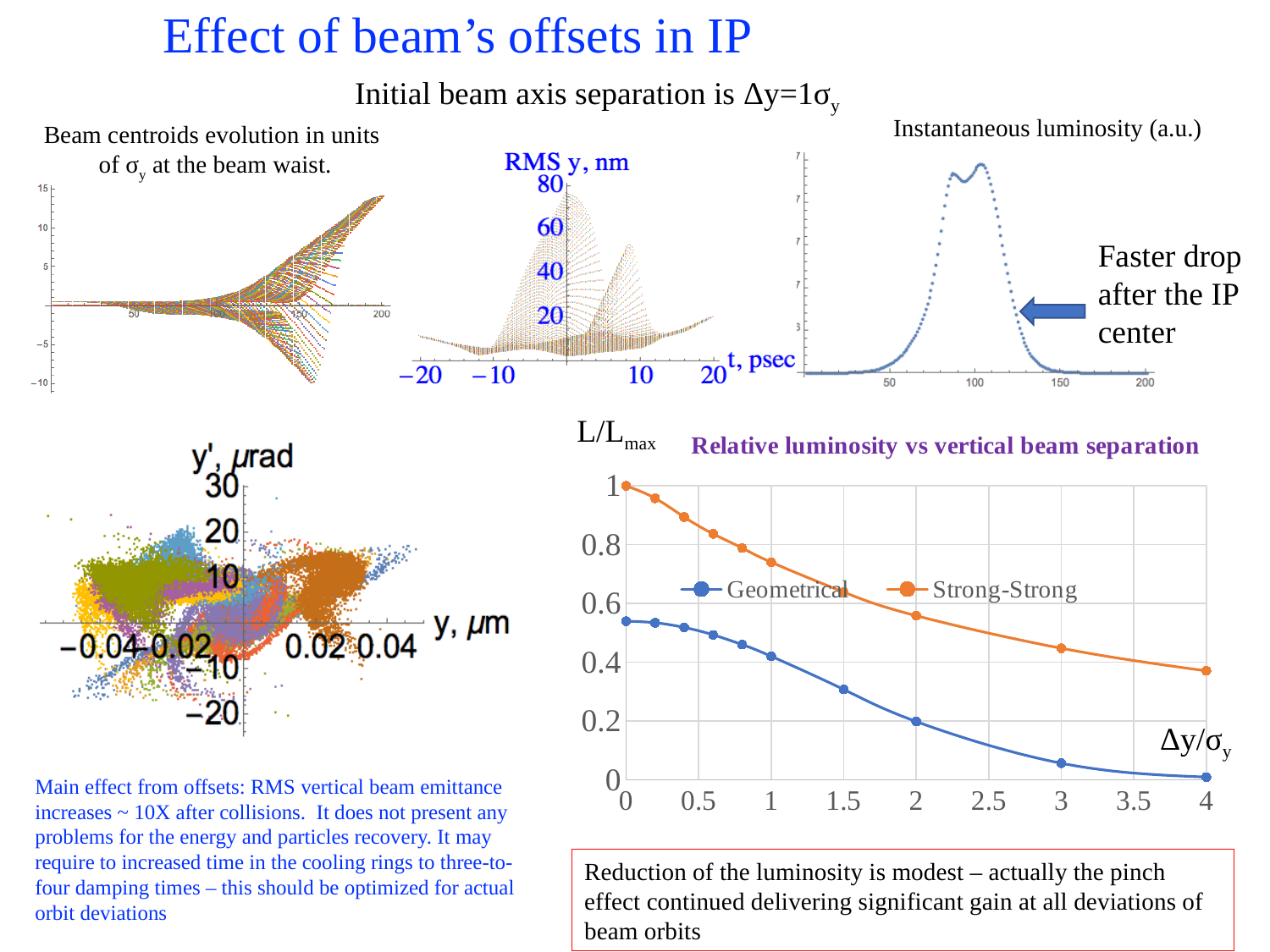
In the chart titled "Relative luminosity vs vertical beam separation", is the Strong-Strong value at Δy/σy = 4 greater or less than 0.4? less In the chart titled "Relative luminosity vs vertical beam separation", how many series does the legend list? 2 In the chart titled "Relative luminosity vs vertical beam separation", do the Geometrical values rise or fall as Δy/σy increases from 0 to 4? fall In the chart titled "Relative luminosity vs vertical beam separation", is the Strong-Strong value at Δy/σy = 2 greater or less than 0.4? greater In the chart titled "Relative luminosity vs vertical beam separation", which series has the larger value at Δy/σy = 2, Geometrical or Strong-Strong? Strong-Strong In the chart titled "Relative luminosity vs vertical beam separation", which series is drawn in orange? Strong-Strong In the chart titled "Relative luminosity vs vertical beam separation", is the Geometrical value at Δy/σy = 3 greater or less than 0.2? less In the chart titled "Relative luminosity vs vertical beam separation", what is the value of the Strong-Strong series at Δy/σy = 0? 1 What kind of chart is "Relative luminosity vs vertical beam separation"? line chart In the chart titled "Relative luminosity vs vertical beam separation", how many data points does the Strong-Strong series have? 10 In the chart titled "Relative luminosity vs vertical beam separation", what are the names of the two series in the legend? Geometrical and Strong-Strong